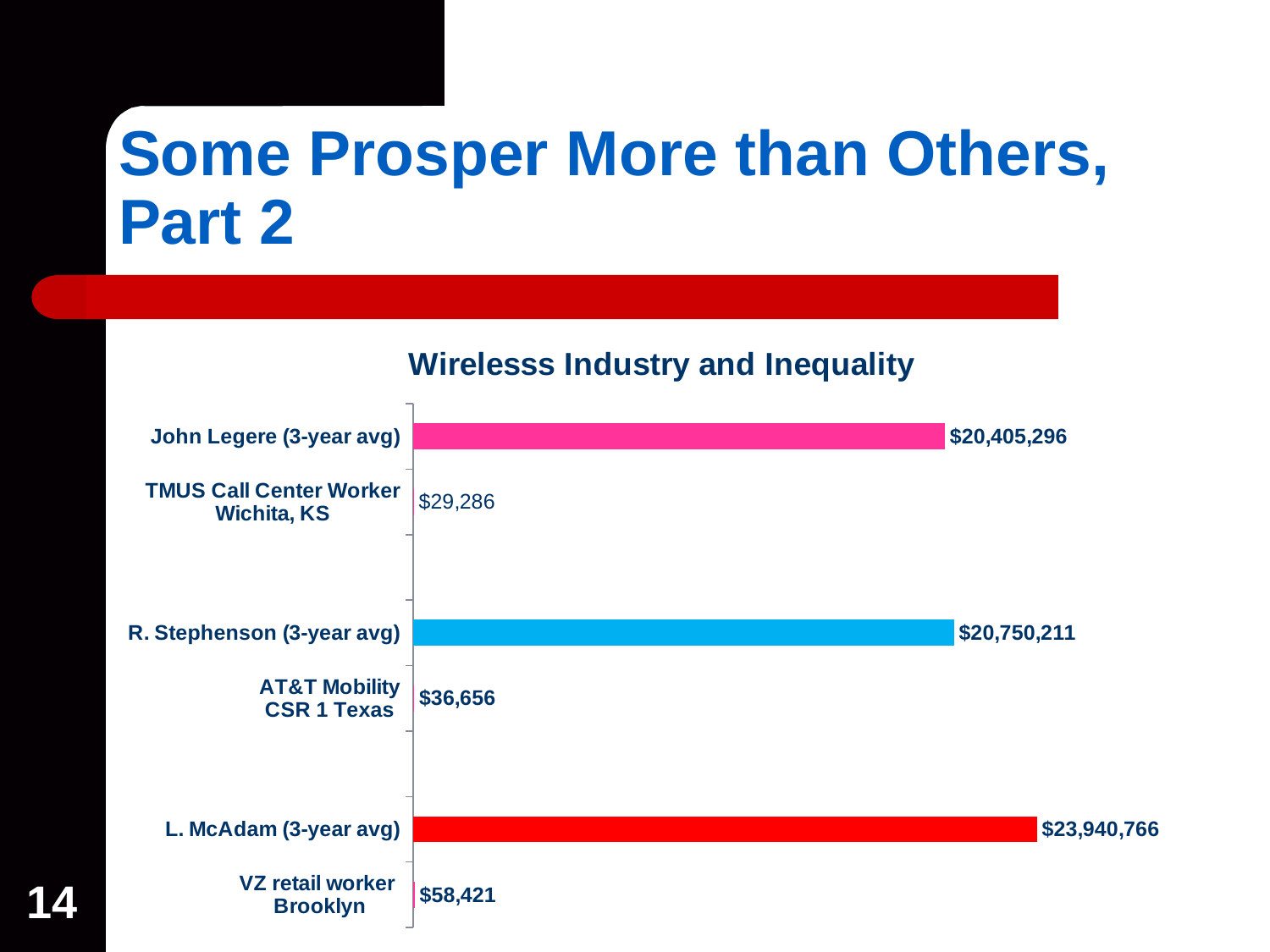
What is the title of the chart? Wirelesss Industry and Inequality How many categories are shown in the chart? 6 What is the value for the VZ retail worker in Brooklyn? $58,421 What is the difference between the values for the VZ retail worker Brooklyn and the TMUS Call Center Worker Wichita, KS? $29,135 Which category has the lowest value? TMUS Call Center Worker Wichita, KS Which category has the highest value? L. McAdam (3-year avg) What is the value for John Legere (3-year avg)? $20,405,296 Which is larger, the value for R. Stephenson (3-year avg) or the value for John Legere (3-year avg)? R. Stephenson (3-year avg) What kind of chart is shown on the slide? Bar chart What is the value for R. Stephenson (3-year avg)? $20,750,211 What is the difference between the values for L. McAdam (3-year avg) and R. Stephenson (3-year avg)? $3,190,555 What is the value for the TMUS Call Center Worker in Wichita, KS? $29,286